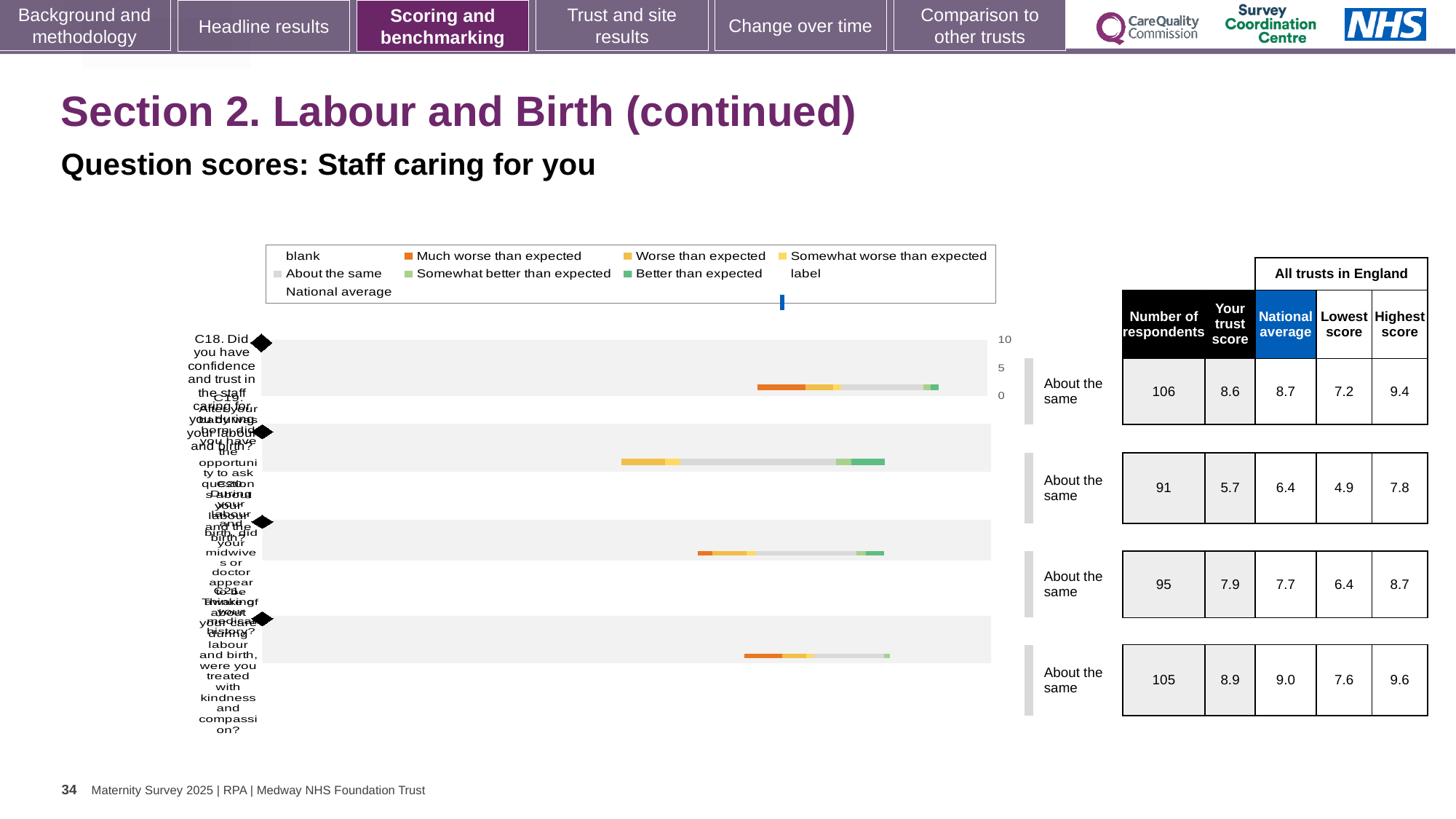
What kind of chart is shown on the slide? bar chart For the fourth row (105 respondents), what is the difference between the highest score and the lowest score? 2.0 How many questions (rows) are plotted in the chart? 4 Which row has the highest 'Your trust score'? the fourth (bottom) row, 8.9 What is the highest score among all trusts in England for the third row, the question with 95 respondents? 8.7 For the first row (106 respondents), which is larger: the trust score or the national average? the national average (8.7) What is the national average for the second row, the question with 91 respondents? 6.4 How many respondents answered the fourth (bottom) question? 105 What is the 'Your trust score' for the first (top) row, the question with 106 respondents? 8.6 What benchmark category is shown for every question on this slide? About the same For the second row (91 respondents), what is the difference between the national average and the trust score? 0.7 Which row has the lowest 'Your trust score'? the second row, 5.7